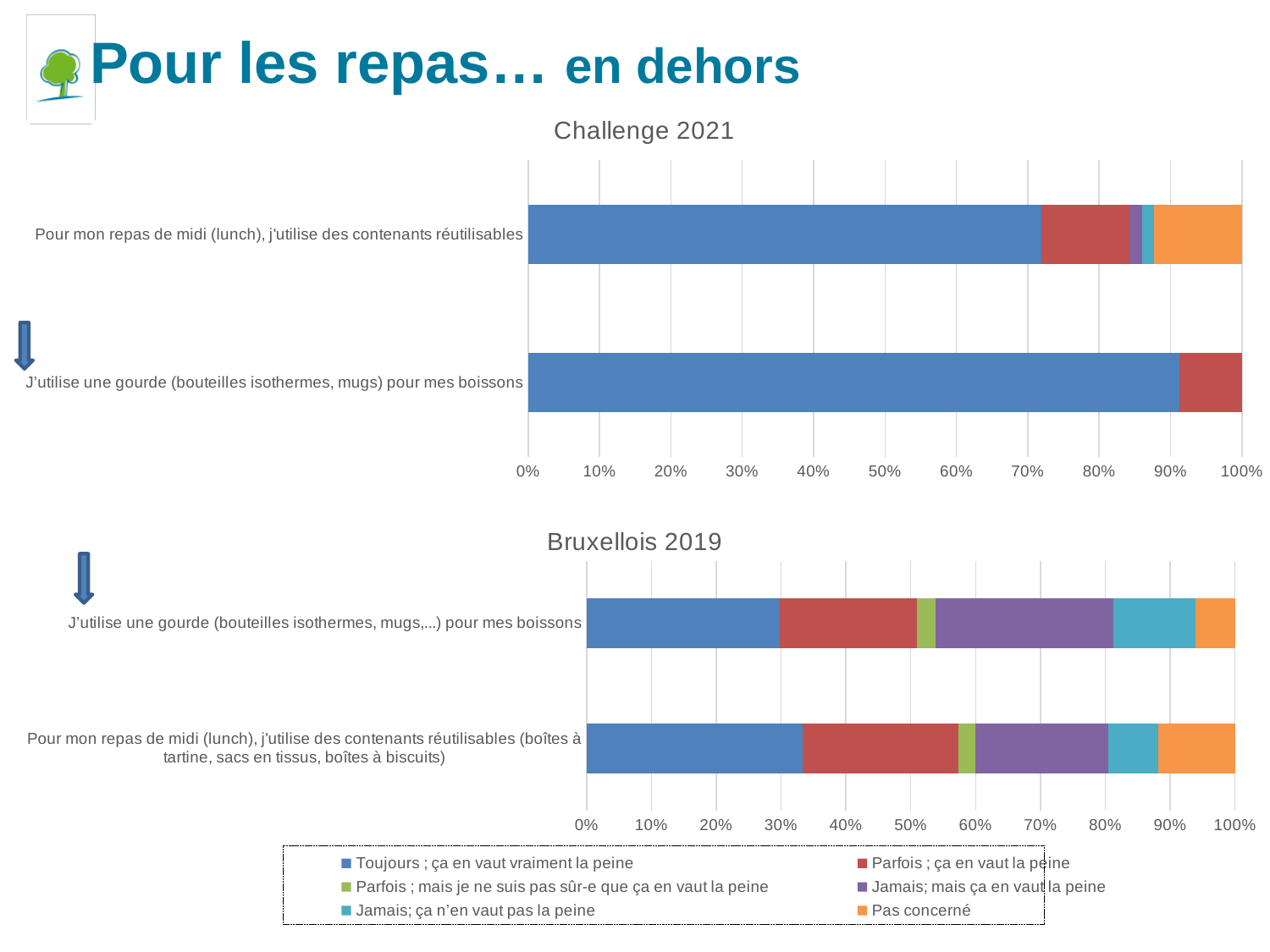
In the Bruxellois 2019 chart, is the 'Toujours ; ça en vaut vraiment la peine' share for 'J'utilise une gourde (bouteilles isothermes, mugs,...) pour mes boissons' greater or less than 40%? less How many categories does the Bruxellois 2019 chart show? 2 What kind of chart is the Challenge 2021 chart? Stacked bar chart In the Challenge 2021 chart, is the 'Toujours ; ça en vaut vraiment la peine' share for 'Pour mon repas de midi (lunch), j'utilise des contenants réutilisables' greater or less than 60%? greater In the Challenge 2021 chart, which category has the highest share of 'Toujours ; ça en vaut vraiment la peine'? J'utilise une gourde (bouteilles isothermes, mugs) pour mes boissons In the Bruxellois 2019 chart, which category has the larger 'Jamais; mais ça en vaut la peine' segment: the gourde statement or the lunch containers statement? J'utilise une gourde (bouteilles isothermes, mugs,...) pour mes boissons What is the title of the upper chart on the slide? Challenge 2021 What colour represents 'Pas concerné' in the legend? Orange How many series does the legend at the bottom of the slide list? 6 In the Challenge 2021 chart, is the 'Toujours ; ça en vaut vraiment la peine' share for 'J'utilise une gourde (bouteilles isothermes, mugs) pour mes boissons' greater or less than 80%? greater How many categories does the Challenge 2021 chart show? 2 In the Challenge 2021 chart, which category has the larger share for 'Toujours ; ça en vaut vraiment la peine': the lunch containers statement or the gourde statement? J'utilise une gourde (bouteilles isothermes, mugs) pour mes boissons